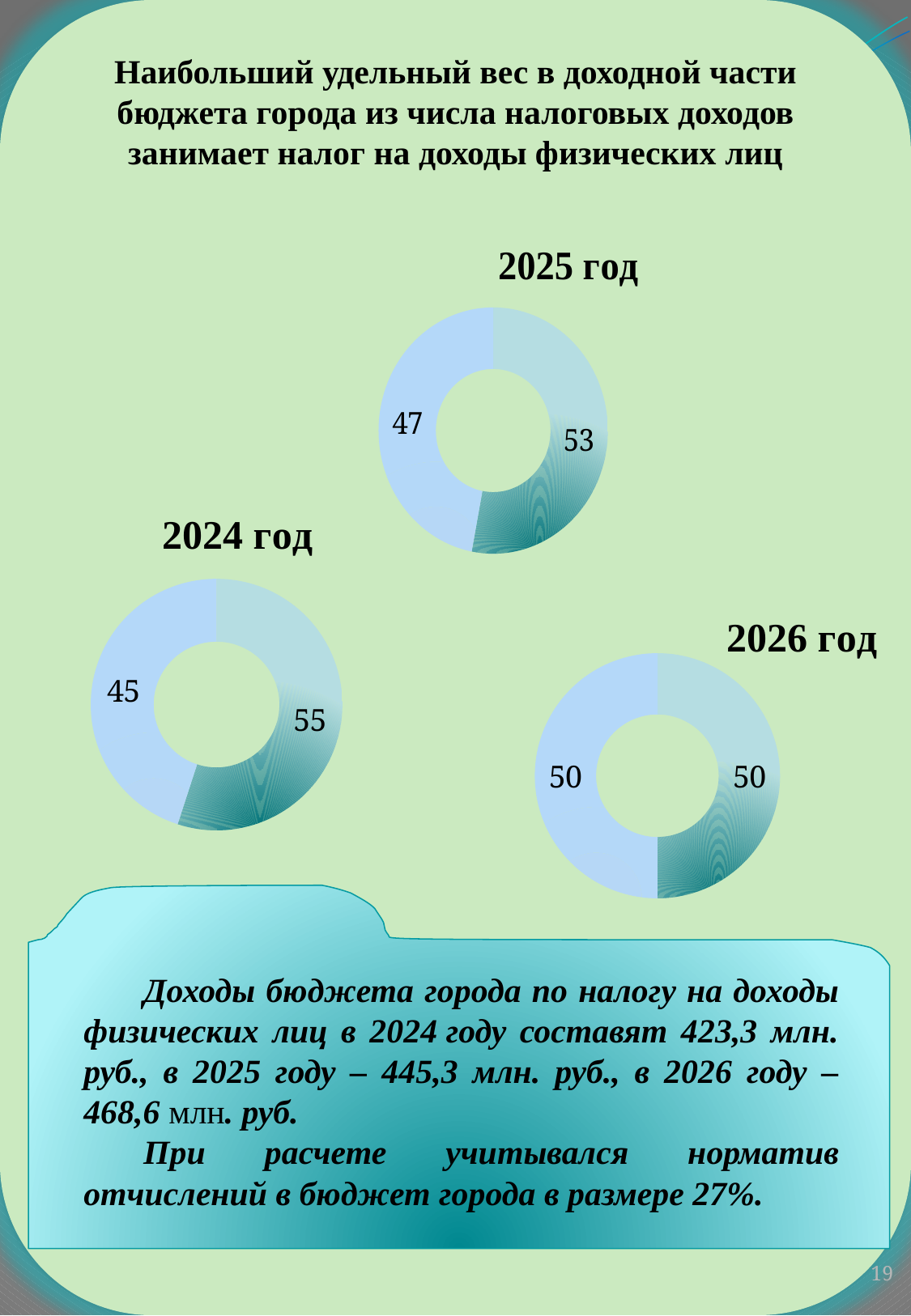
In the "2024 год" chart, what is the difference between the two slice values? 10 How many doughnut charts are shown on the slide, and what are their titles? 3: 2024 год, 2025 год, 2026 год In the "2024 год" chart, which slice is larger, the light blue one or the teal one? the teal one (55) How many slices does the "2025 год" chart have? 2 In the "2025 год" chart, what is the difference between the two slice values? 6 In the "2025 год" chart, what is the value of the light blue slice on the left? 47 In the "2024 год" chart, what is the value of the light blue slice on the left? 45 In the "2026 год" chart, what is the value of each of the two slices? 50 In the "2025 год" chart, what is the value of the teal slice on the right? 53 In the "2024 год" chart, what share of the whole does the light blue slice represent? 45% What kind of chart is the "2024 год" chart? doughnut chart In the "2024 год" chart, what is the value of the teal slice on the right? 55